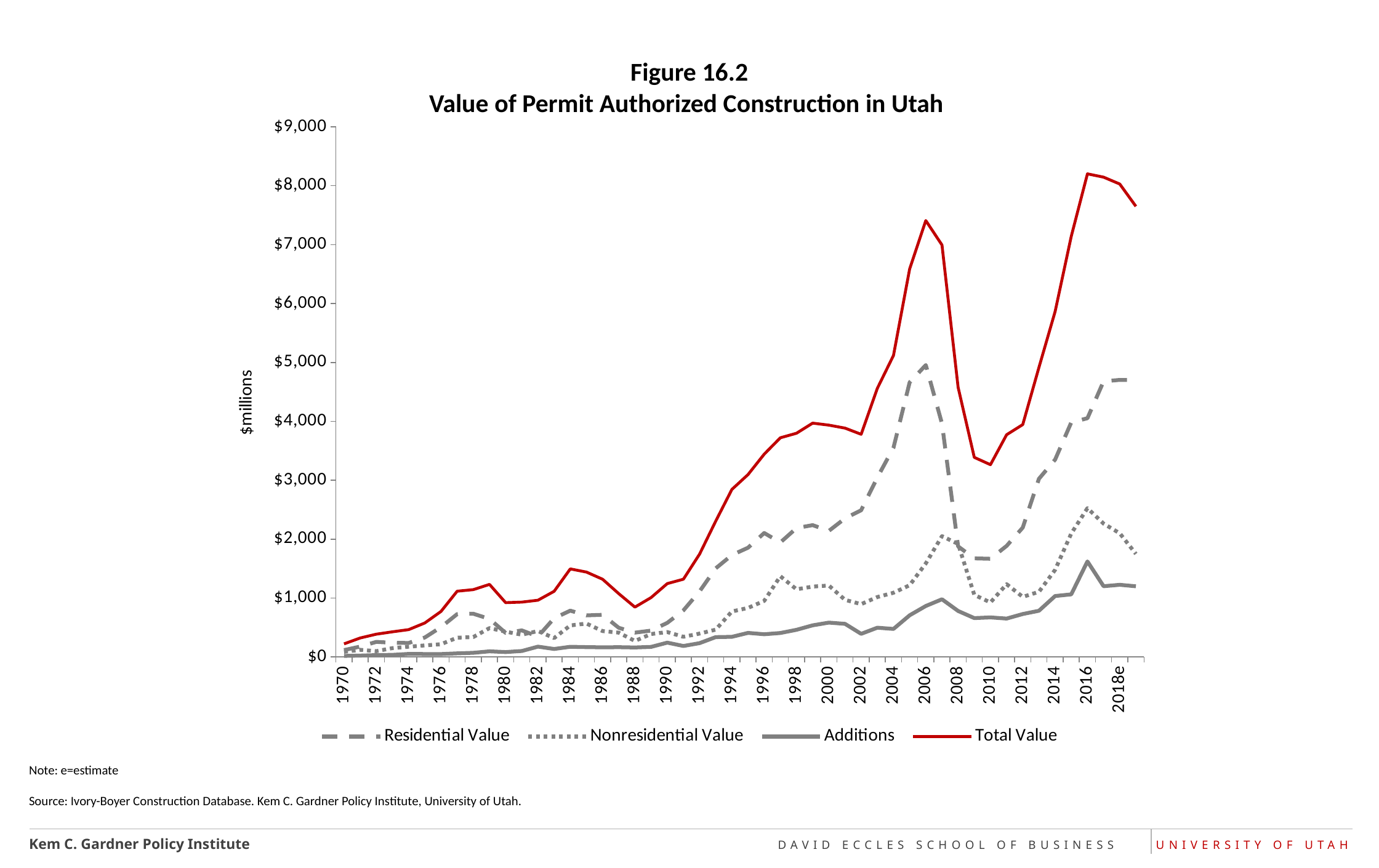
How many series does the legend list? 4 What kind of chart is shown in Figure 16.2? line chart Which series is drawn in red? Total Value Is the Total Value for 2006 greater or less than $7,000? greater Is the Total Value for 2010 greater or less than $4,000? less In 2016, which is larger: Residential Value or Nonresidential Value? Residential Value Does the Total Value rise or fall between 2006 and 2010? fall Is the Nonresidential Value for 2016 greater or less than $2,000? greater In which year does the Total Value line reach its highest point? 2016 What unit is shown on the y-axis label? $millions